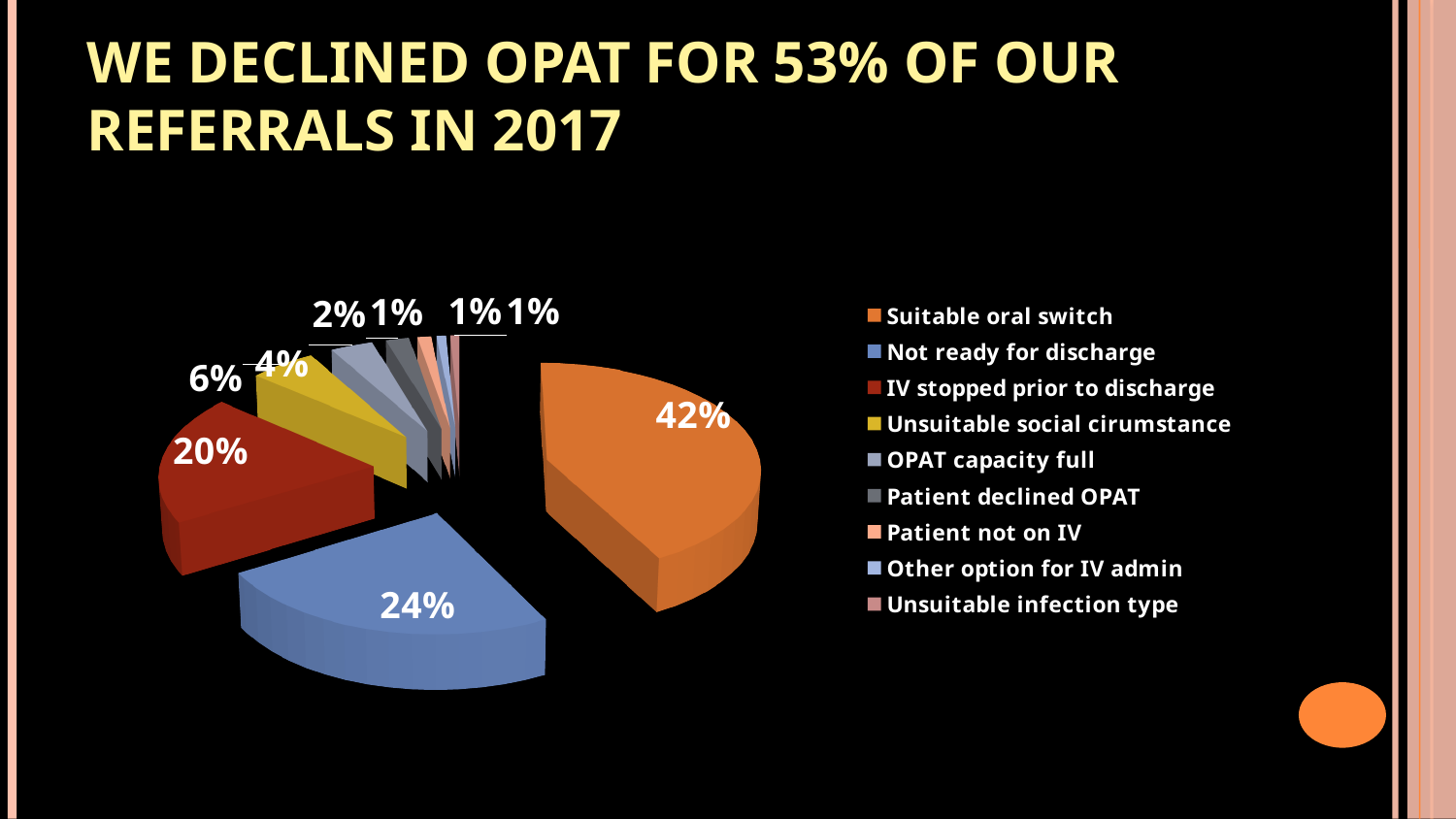
Which category has the largest share of the pie? Suitable oral switch What colour is the slice for Suitable oral switch? Orange What is the title of the slide containing the chart? We declined OPAT for 53% of our referrals in 2017 What kind of chart is shown on the slide? Pie chart Which is larger: the share for Not ready for discharge or the share for IV stopped prior to discharge? Not ready for discharge What percentage of the pie is labelled for Suitable oral switch? 42% What percentage is shown for Not ready for discharge? 24% What percentage is shown for OPAT capacity full? 4% What percentage is shown for Unsuitable social cirumstance? 6% How many categories does the legend list? 9 What percentage is shown for IV stopped prior to discharge? 20% What is the difference in percentage points between Suitable oral switch and Not ready for discharge? 18 percentage points